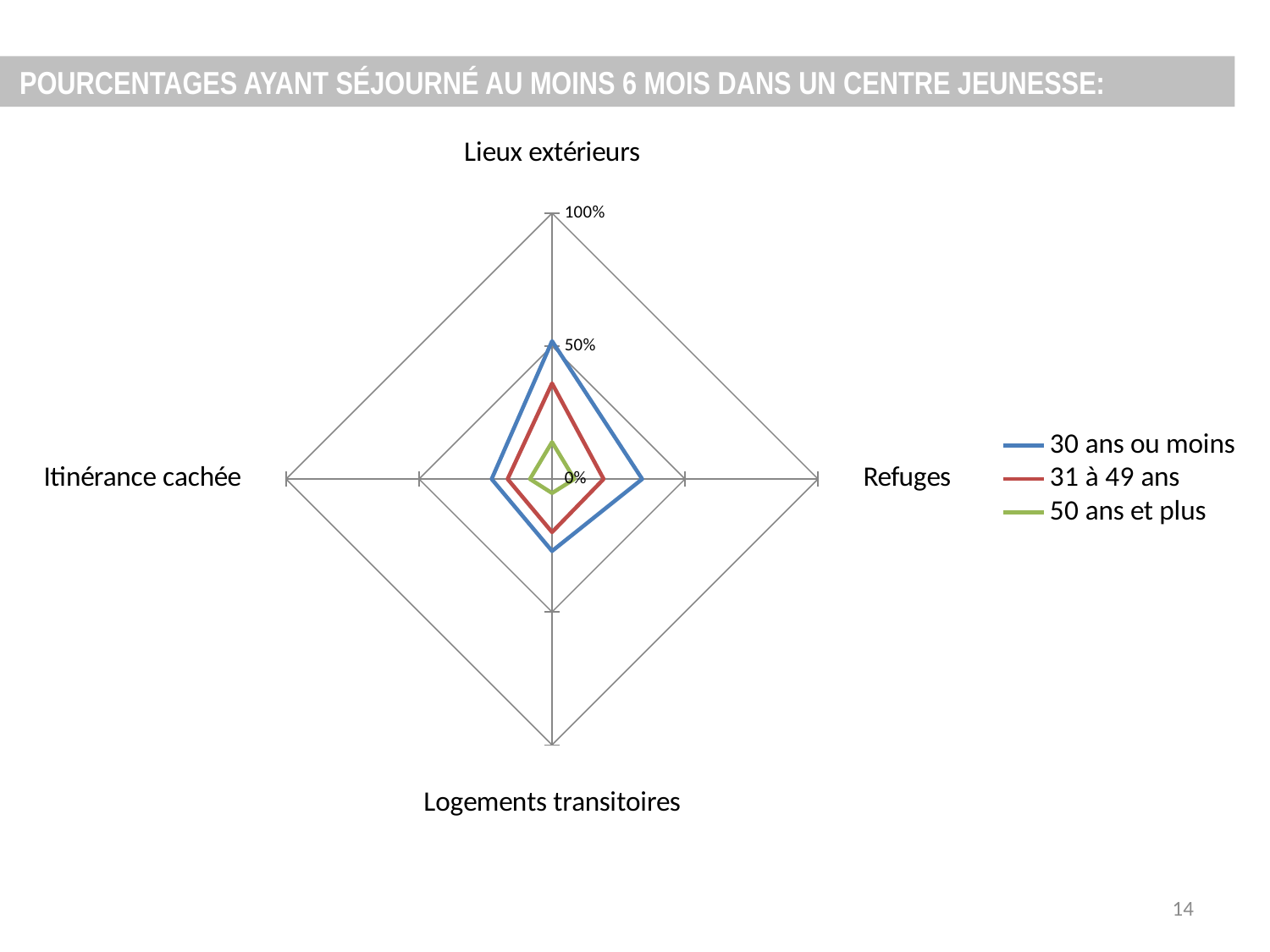
For the series 50 ans et plus, which category has the highest value? Lieux extérieurs For the category Refuges, which series has the larger value: 31 à 49 ans or 50 ans et plus? 31 à 49 ans Is the value for Logements transitoires in the series 50 ans et plus greater or less than 50%? less Is the value for Refuges in the series 30 ans ou moins greater or less than 50%? less For the series 30 ans ou moins, which category has the highest value? Lieux extérieurs How many categories (axes) does the radar chart have? 4 What is the title of the chart? POURCENTAGES AYANT SÉJOURNÉ AU MOINS 6 MOIS DANS UN CENTRE JEUNESSE: For the series 31 à 49 ans, which category has the highest value? Lieux extérieurs For the category Lieux extérieurs, which series has the larger value: 30 ans ou moins or 31 à 49 ans? 30 ans ou moins What kind of chart is shown on the slide? Radar chart How many series does the legend list? 3 Which series is listed first in the legend? 30 ans ou moins